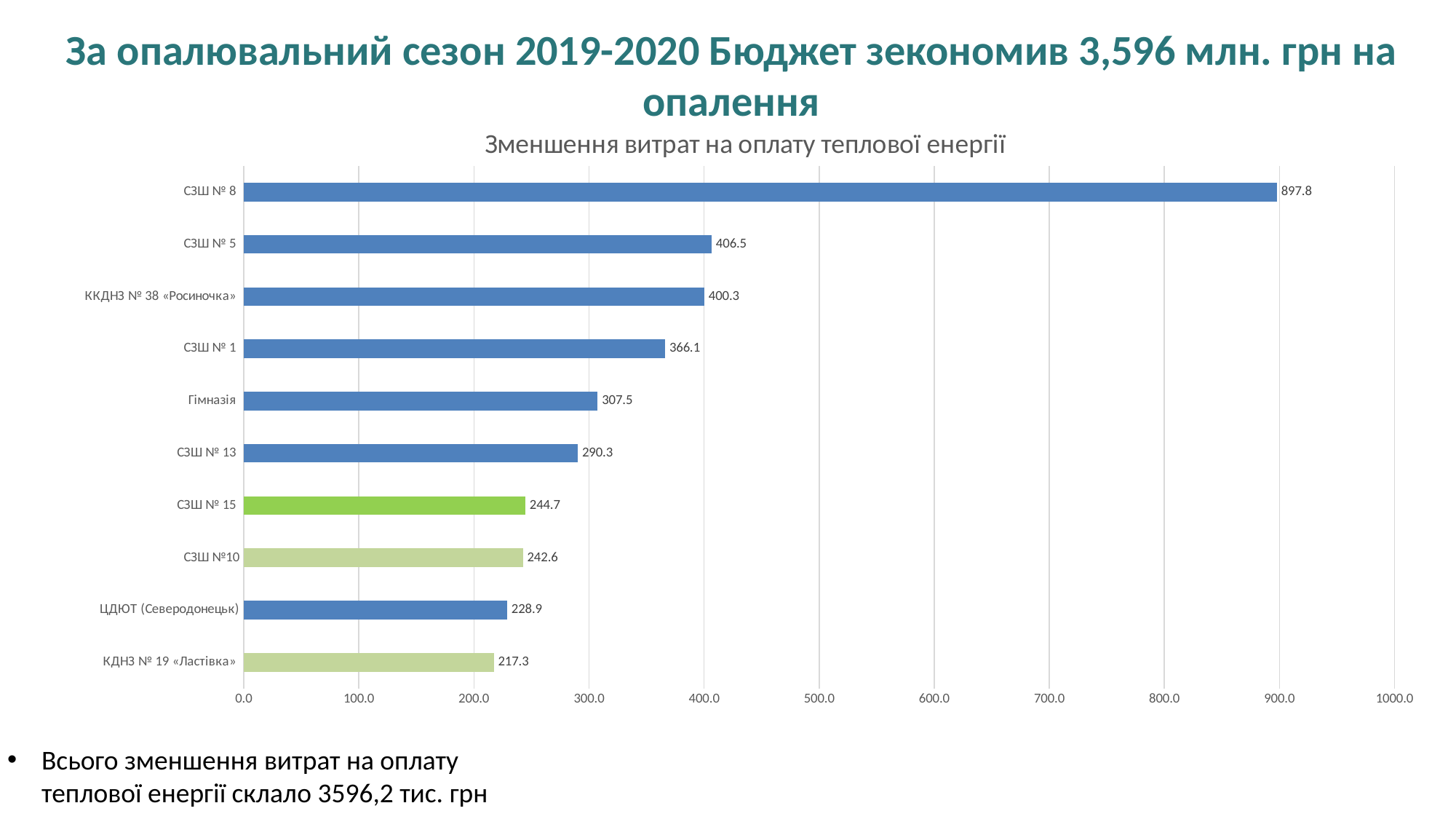
Which category has the highest value? СЗШ № 8 How many categories are shown in the chart? 10 What is the value for ККДНЗ № 38 «Росиночка»? 400.3 What is the value for ЦДЮТ (Северодонецьк)? 228.9 What is the title of the chart? Зменшення витрат на оплату теплової енергії Is the value for СЗШ № 1 greater or less than 300? greater What is the difference between the values for СЗШ № 8 and СЗШ № 5? 491.3 Which category has the lowest value? КДНЗ № 19 «Ластівка» What is the difference between the values for Гімназія and СЗШ № 13? 17.2 Which is larger, the value for Гімназія or the value for СЗШ № 13? Гімназія What is the value for СЗШ № 8? 897.8 What kind of chart is shown on the slide? bar chart